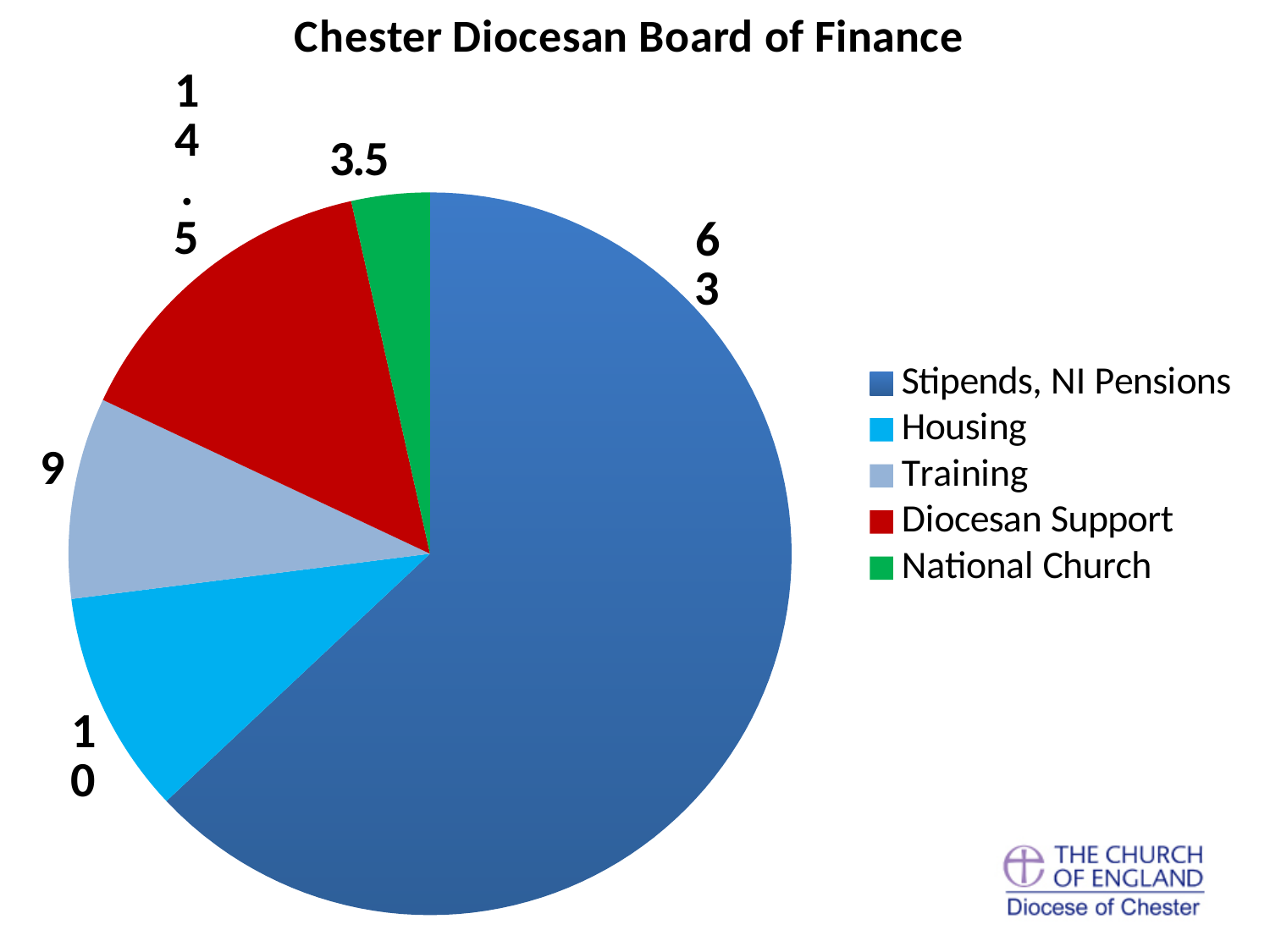
How many entries does the legend list? 5 What is the value for Housing? 10 Which category has the largest slice? Stipends, NI Pensions What is the difference between the values for Diocesan Support and Housing? 4.5 What is the title of the chart? Chester Diocesan Board of Finance Which category has the smallest slice? National Church What is the value for Training? 9 What kind of chart is shown on the slide? pie chart What is the value for National Church? 3.5 What is the value for Stipends, NI Pensions? 63 How many slices does the pie chart have? 5 What is the value for Diocesan Support? 14.5